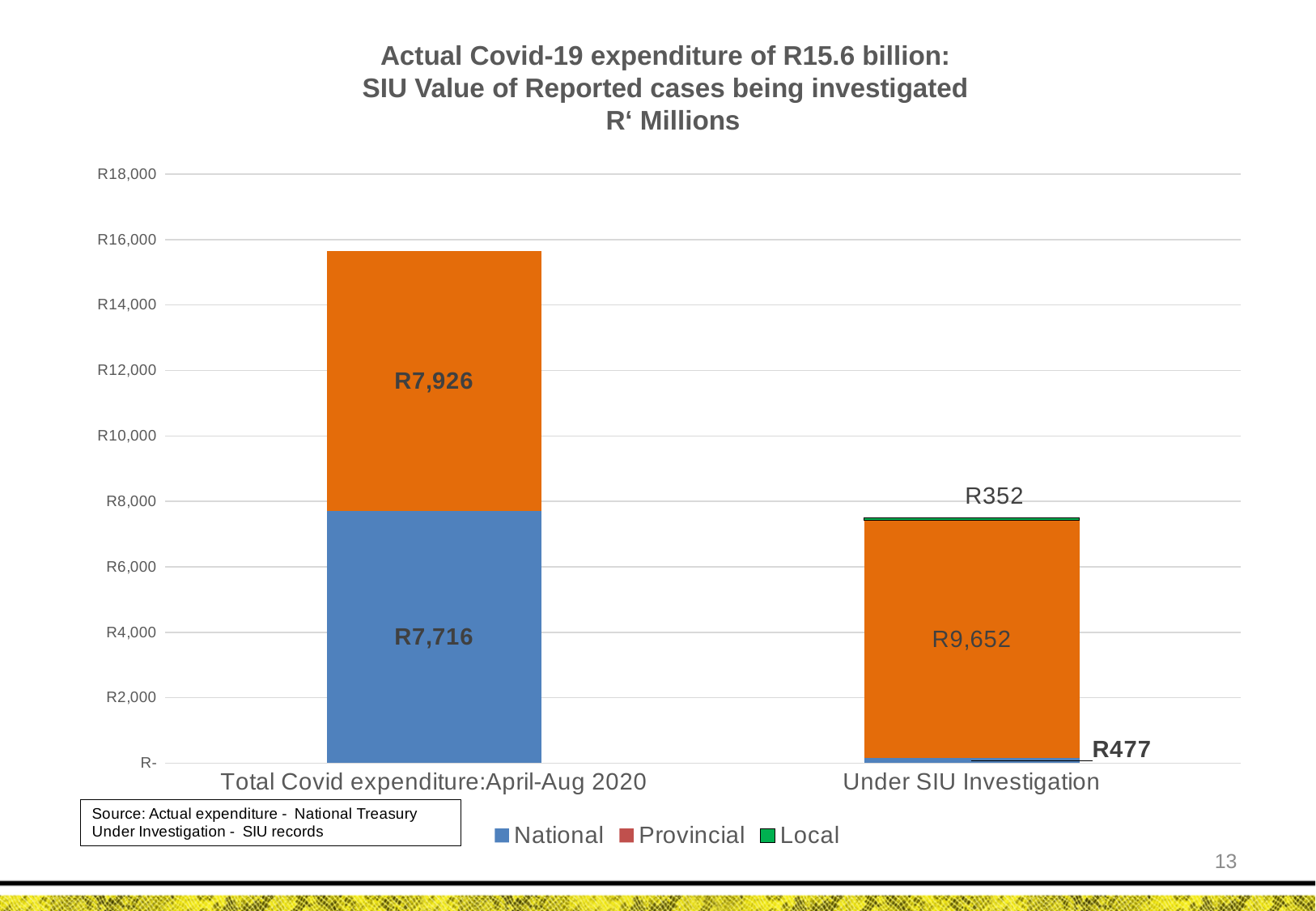
Is the total height of the Under SIU Investigation bar greater or less than R8,000? less What is the value of the Provincial segment for Total Covid expenditure:April-Aug 2020? R7,926 What kind of chart is shown on the slide? Stacked bar chart What is the value of the Local segment for Under SIU Investigation? R352 What is the value of the National segment for Total Covid expenditure:April-Aug 2020? R7,716 What is the value of the National segment for Under SIU Investigation? R477 What is the total of the stacked bar for Total Covid expenditure:April-Aug 2020? R15,642 What is the difference between the Provincial and National segments for Total Covid expenditure:April-Aug 2020? R210 Which bar is taller overall, Total Covid expenditure:April-Aug 2020 or Under SIU Investigation? Total Covid expenditure:April-Aug 2020 How many categories are shown on the x axis? 2 What is the value of the Provincial segment for Under SIU Investigation? R9,652 How many series does the legend list? 3